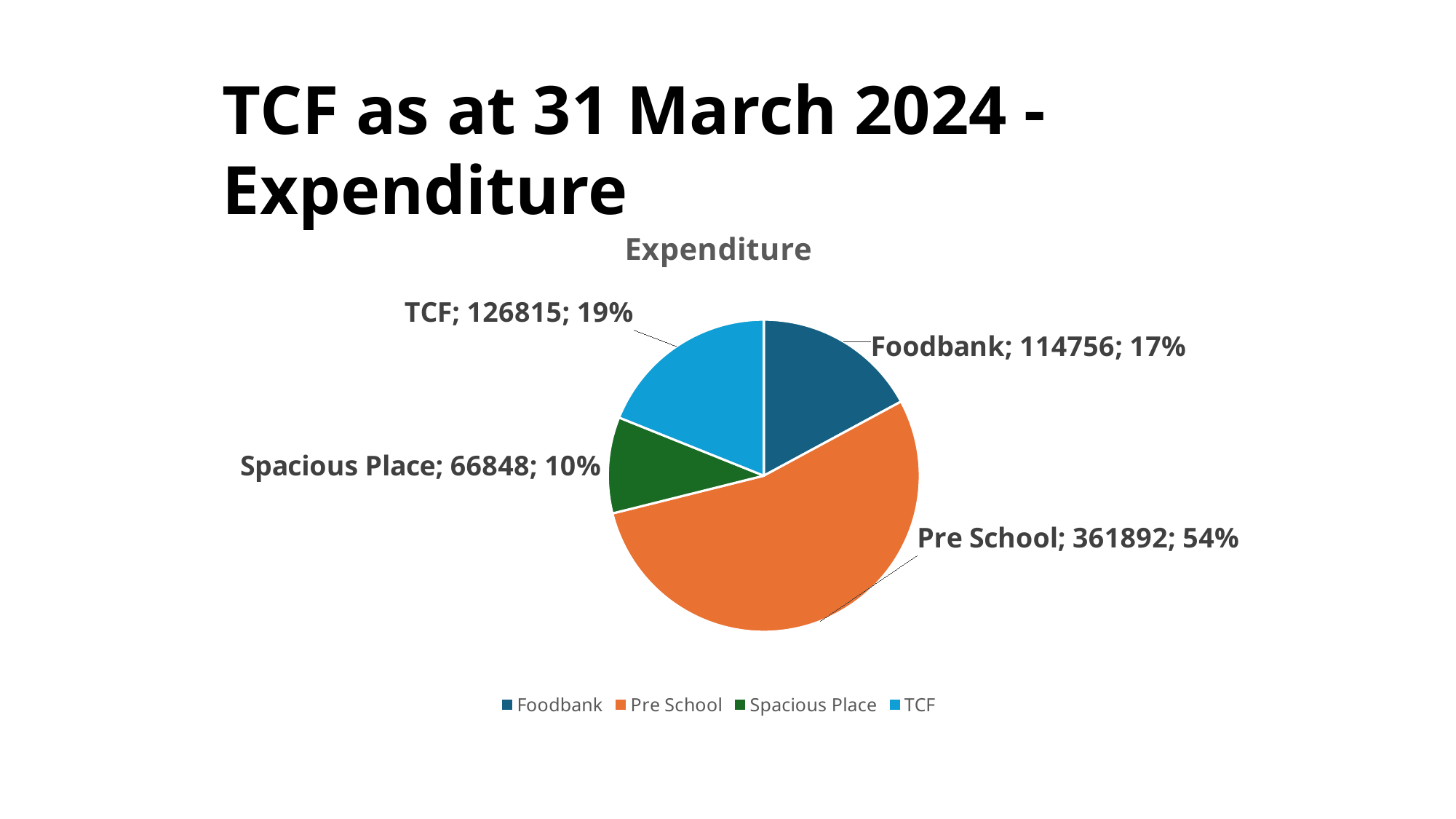
What is the difference between the TCF and Foodbank expenditure values? 12059 What is the expenditure value for TCF? 126815 Which category has the lowest expenditure? Spacious Place What type of chart is shown on the slide? Pie chart How many categories are shown in the pie chart? 4 Which category has the highest expenditure? Pre School What is the expenditure value for Spacious Place? 66848 What is the expenditure value for Pre School? 361892 Which is larger, the expenditure for TCF or for Foodbank? TCF What is the expenditure value for Foodbank? 114756 What share of the pie does Pre School represent? 54% What share of the pie does TCF represent? 19%